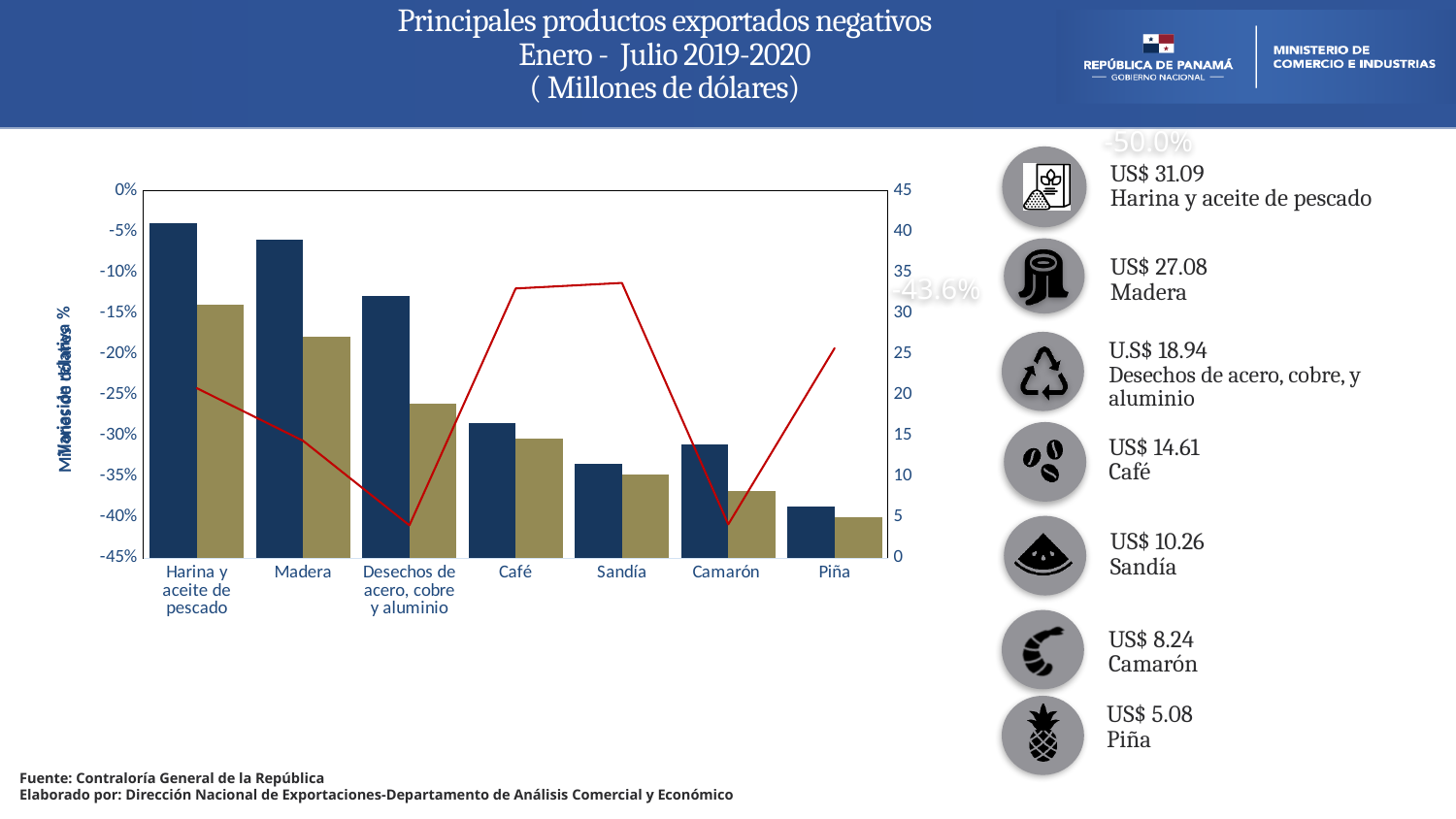
Is the dark blue bar for Harina y aceite de pescado greater or less than 35 on the right axis? greater How many product categories are shown on the x axis of the chart? 7 Is the dark blue bar for Café greater or less than 20 on the right axis? less Which category has the tallest olive (second) bar? Harina y aceite de pescado What kind of chart is shown on the slide? combination bar and line chart Is the olive bar for Madera greater or less than 25 on the right axis? greater Which category has the shortest dark blue (first) bar? Piña Which category has the shortest olive (second) bar? Piña Which is taller, the dark blue bar for Desechos de acero, cobre y aluminio or the dark blue bar for Café? Desechos de acero, cobre y aluminio Do the olive (second) bars rise or fall from left to right across the categories? fall What is the highest tick value shown on the right-hand axis of the chart? 45